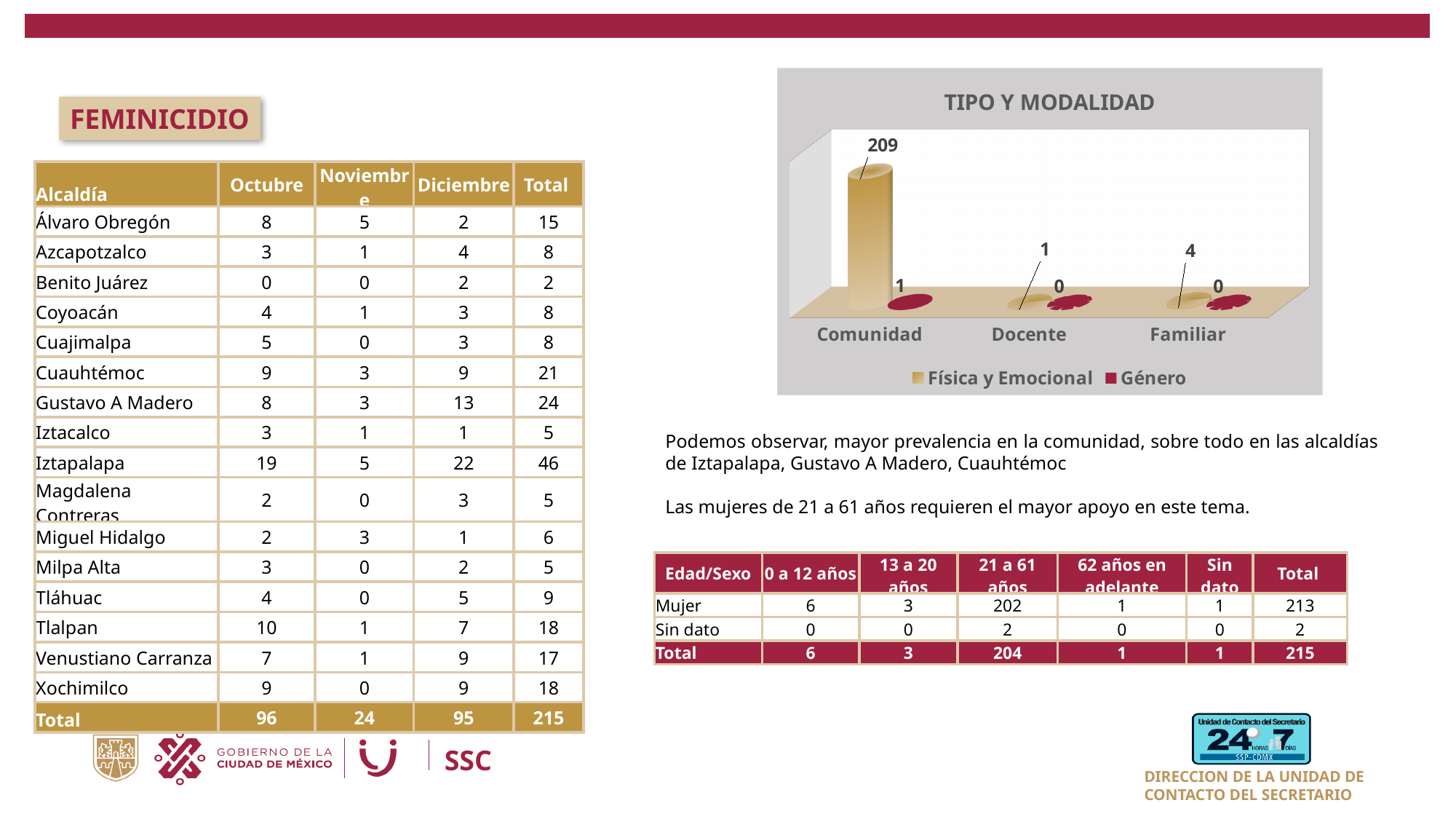
In the 'TIPO Y MODALIDAD' chart, what is the value of Género for Docente? 0 In the 'TIPO Y MODALIDAD' chart, what is the value of Género for Comunidad? 1 In the 'TIPO Y MODALIDAD' chart, which is larger for Familiar: Física y Emocional or Género? Física y Emocional How many categories are shown on the x axis of the 'TIPO Y MODALIDAD' chart? 3 In the 'TIPO Y MODALIDAD' chart, which category has the lowest Física y Emocional value? Docente What are the two series named in the legend of the 'TIPO Y MODALIDAD' chart? Física y Emocional and Género In the 'TIPO Y MODALIDAD' chart, what is the value of Física y Emocional for Familiar? 4 In the 'TIPO Y MODALIDAD' chart, what is the value of Física y Emocional for Comunidad? 209 How many series does the legend of the 'TIPO Y MODALIDAD' chart list? 2 In the 'TIPO Y MODALIDAD' chart, which category has the highest Física y Emocional value? Comunidad What kind of chart is 'TIPO Y MODALIDAD'? Bar chart In the 'TIPO Y MODALIDAD' chart, what is the difference between the Física y Emocional values for Comunidad and Familiar? 205